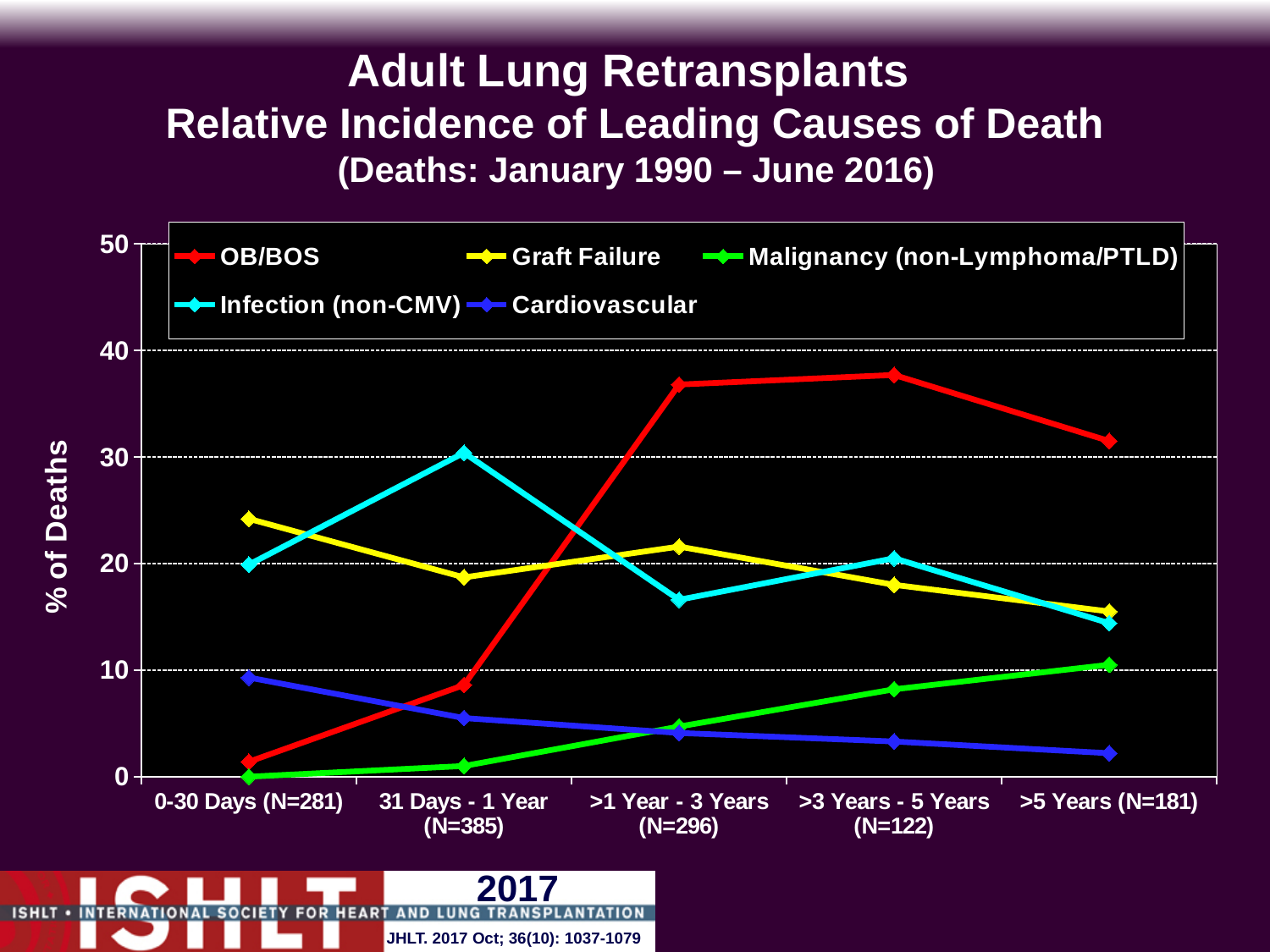
Is the value for Cardiovascular in the >5 Years period greater or less than 10? less Is the value for OB/BOS in the >1 Year - 3 Years period greater or less than 30? greater Which cause of death has the highest value in the 0-30 Days period? Graft Failure Which cause of death has the lowest value in the 0-30 Days period? Malignancy (non-Lymphoma/PTLD) Is the value for Infection (non-CMV) in the 31 Days - 1 Year period greater or less than 20? greater Does the Malignancy (non-Lymphoma/PTLD) line rise or fall across the time periods from left to right? rise What kind of chart is shown on the slide? line chart In the >5 Years period, which is larger: OB/BOS or Graft Failure? OB/BOS Which cause of death has the highest value in the >3 Years - 5 Years period? OB/BOS How many series does the legend list? 5 How many time-period categories are shown on the x axis? 5 Does the Cardiovascular line rise or fall across the time periods from left to right? fall